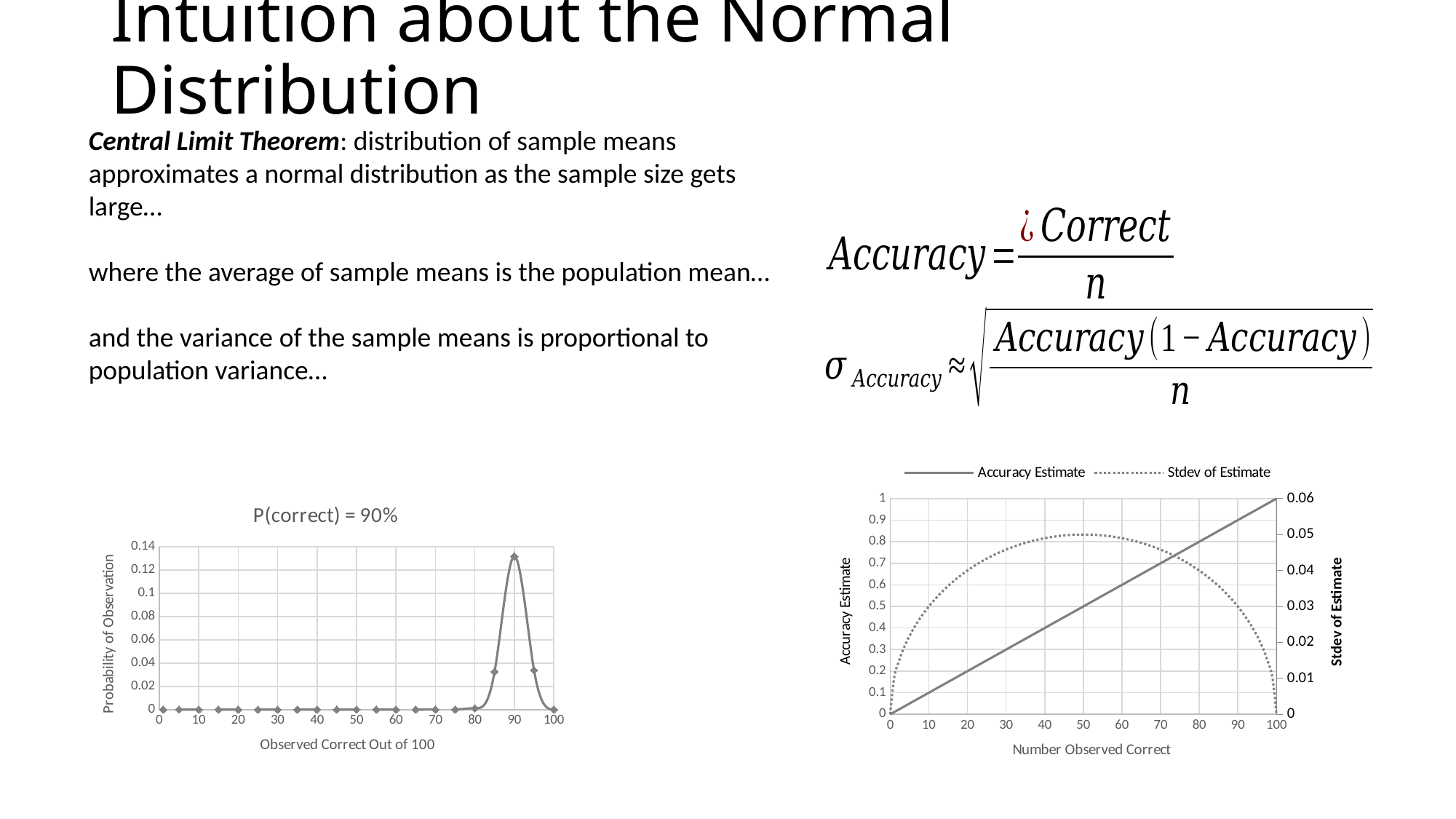
In the chart on the right, what is the title of the secondary (right-hand) y axis? Stdev of Estimate In the chart on the right, at which Number Observed Correct is the Stdev of Estimate highest? 50 In the chart on the right, does the Accuracy Estimate rise or fall as the Number Observed Correct increases? rise In the chart titled "P(correct) = 90%", at which value of Observed Correct Out of 100 is the probability highest? 90 In the chart titled "P(correct) = 90%", what is the x-axis title? Observed Correct Out of 100 In the chart titled "P(correct) = 90%", how many data points are plotted? 21 In the chart on the right, what is the Accuracy Estimate when the Number Observed Correct is 50? 0.5 In the chart on the right, how many series does the legend list? 2 In the chart on the right, what is the Stdev of Estimate when the Number Observed Correct is 50? 0.05 In the chart titled "P(correct) = 90%", is the probability at 85 observed correct greater or less than 0.04? less In the chart titled "P(correct) = 90%", is the probability at 90 observed correct greater or less than 0.1? greater What kind of chart is the chart titled "P(correct) = 90%"? line chart